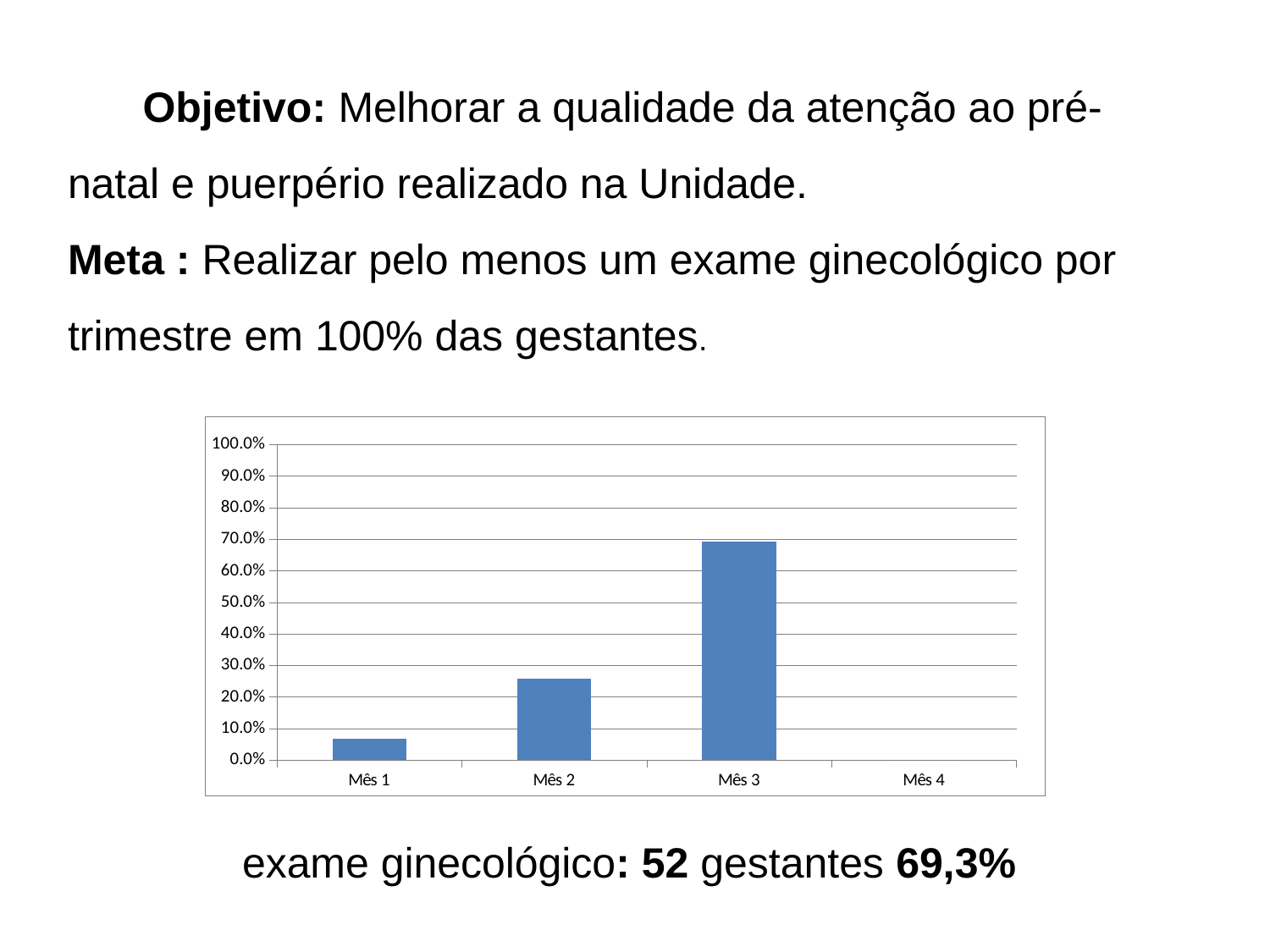
Is the value for Mês 1 greater or less than 10.0%? less How many months (categories) are shown on the x axis of the chart? 4 Do the values rise or fall from Mês 1 to Mês 3? rise Among the months with a visible bar, which has the lowest value? Mês 1 Is the value for Mês 3 greater or less than 60.0%? greater Which month has the highest bar in the chart? Mês 3 What is the highest value shown on the y axis of the chart? 100.0% Which is larger, the value for Mês 2 or the value for Mês 3? Mês 3 What kind of chart is shown on the slide? bar chart Is the value for Mês 2 greater or less than 20.0%? greater What colour are the bars in the chart? blue